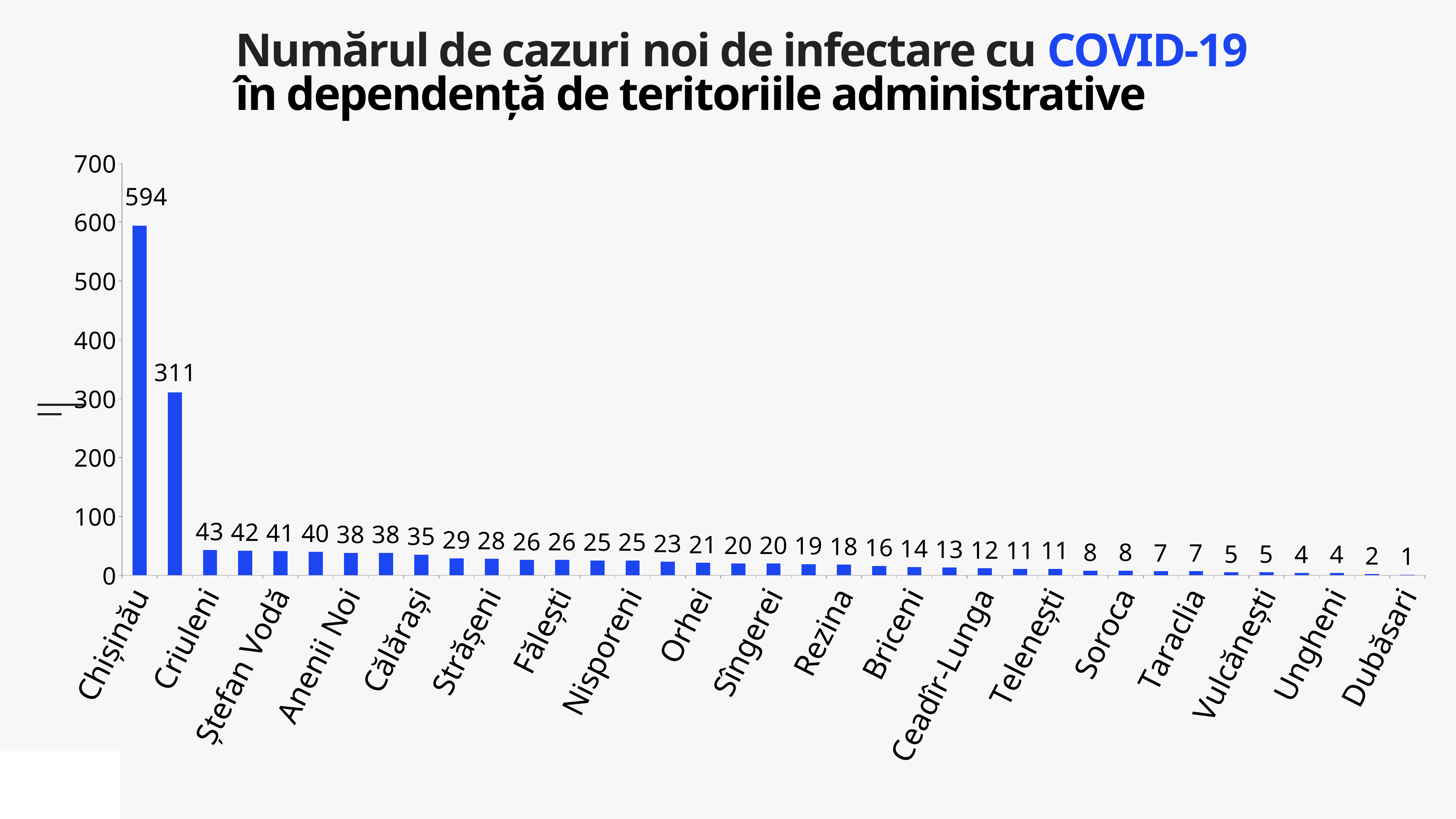
What kind of chart is shown on the slide? bar chart What is the value for Dubăsari? 1 What is the value for Chișinău? 594 What is the difference between the value for Chișinău and the value for Dubăsari? 593 What is the value of the second-highest bar? 311 What is the highest value shown on the vertical axis? 700 Which word in the chart title is highlighted in blue? COVID-19 Is the value for Chișinău greater or less than 500? greater Which is larger, the value for Chișinău or the value for Criuleni? Chișinău Do the values rise or fall from left to right along the x axis? fall Which territory has the highest number of new cases? Chișinău Which territory has the lowest number of new cases? Dubăsari